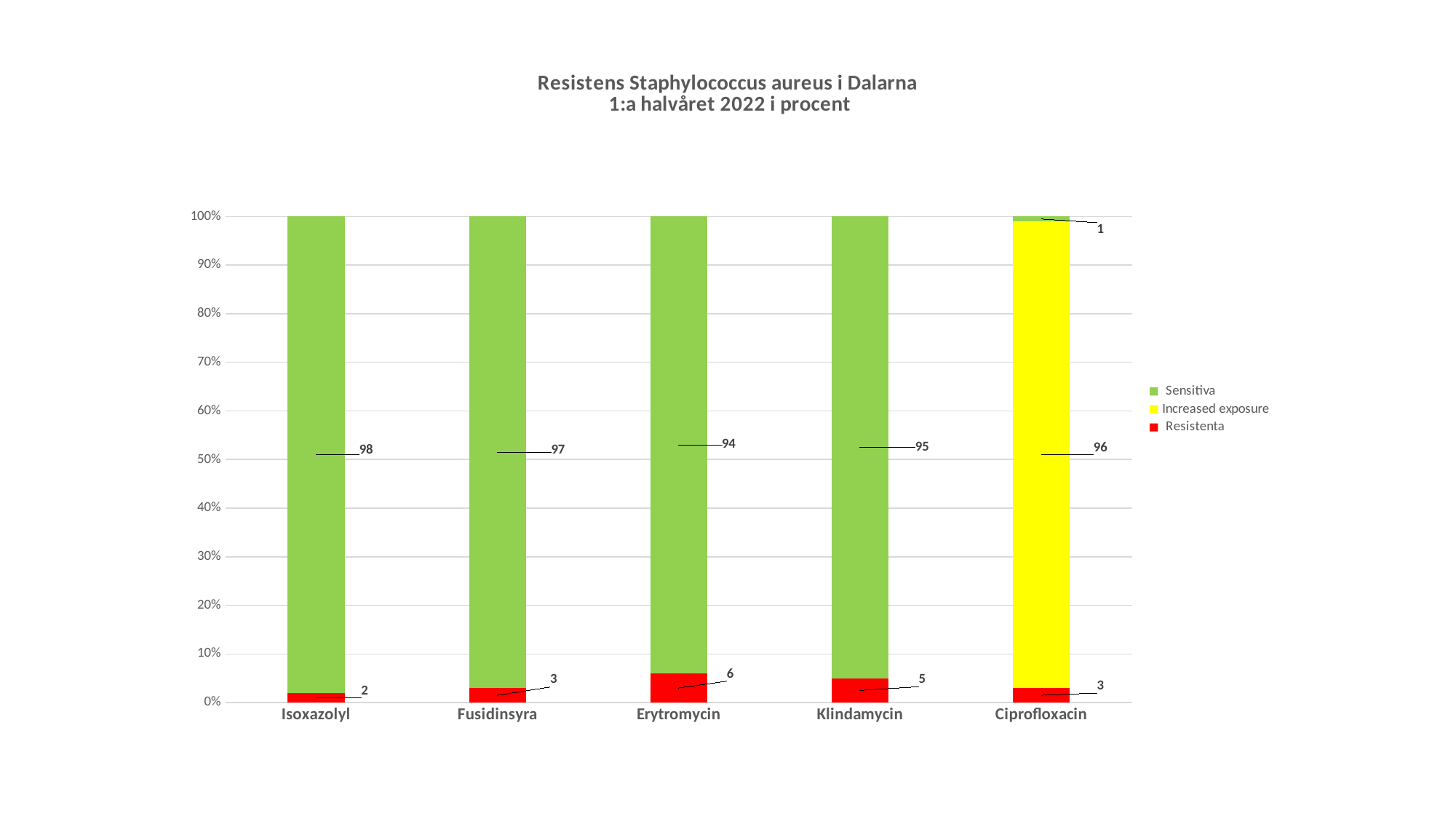
Which antibiotic has the lowest Resistenta value? Isoxazolyl What is the Sensitiva value for Isoxazolyl? 98 What is the total of the labelled segments in the Ciprofloxacin bar? 100 Which antibiotic has the highest Resistenta value? Erytromycin How many series does the legend list? 3 Which has a larger Sensitiva value, Fusidinsyra or Klindamycin? Fusidinsyra What is the Sensitiva value for Ciprofloxacin? 1 What kind of chart is shown on the slide? Stacked bar chart How many antibiotics are shown on the x axis? 5 What is the Increased exposure value for Ciprofloxacin? 96 What is the difference between the Resistenta values for Erytromycin and Isoxazolyl? 4 What is the Resistenta value for Erytromycin? 6